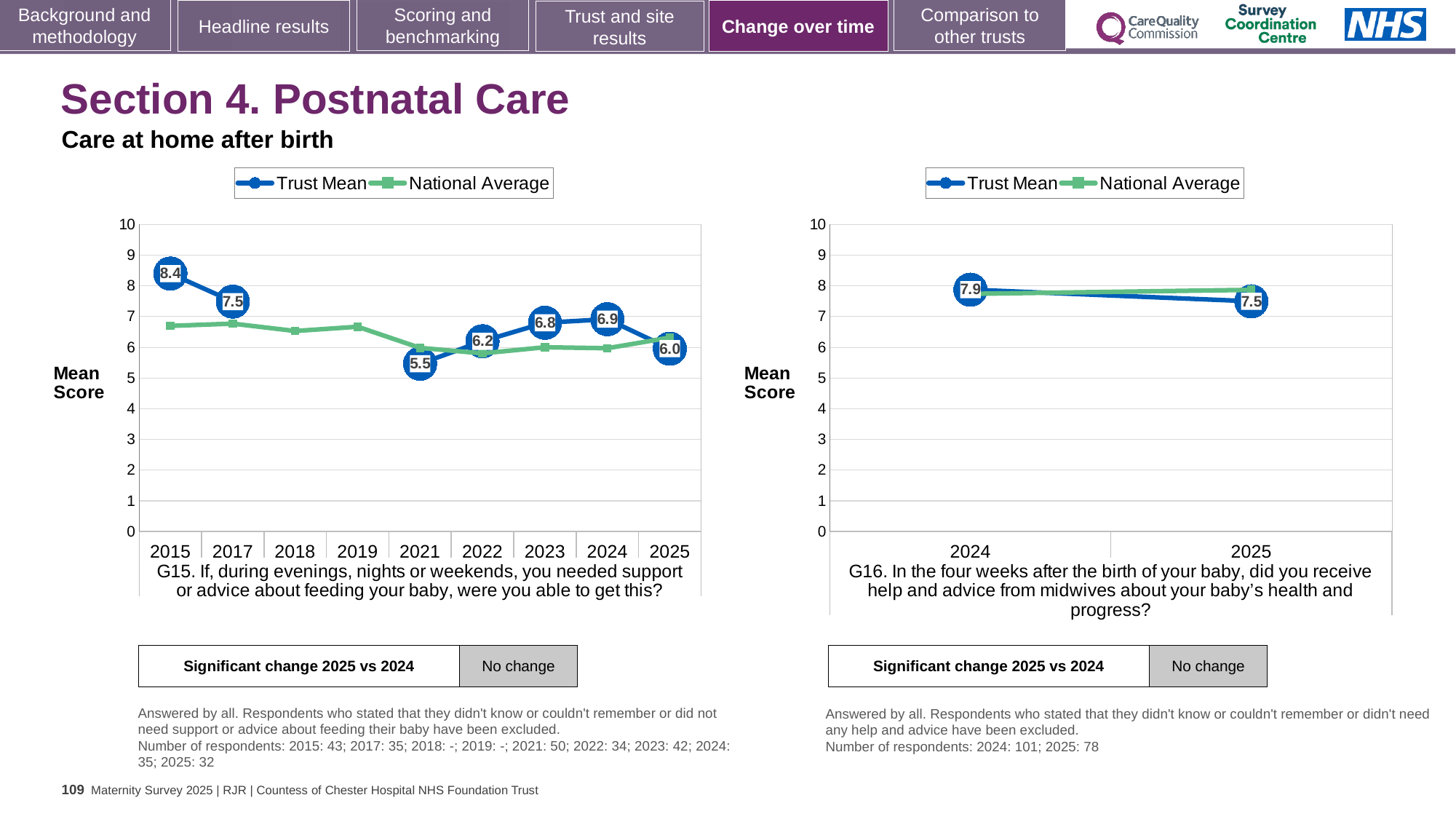
In the G15 chart on the left, which year has the lowest Trust Mean score? 2021 In the G15 chart on the left, which year has the highest Trust Mean score? 2015 In the G15 chart on the left, what is the Trust Mean score for 2025? 6.0 How many years are shown on the x axis of the G16 chart on the right? 2 In the G15 chart on the left, what is the Trust Mean score for 2015? 8.4 In the G15 chart on the left, is the Trust Mean score higher in 2023 or in 2022? 2023 In the G15 chart on the left, is the National Average for 2015 greater or less than 6? greater In the G15 chart on the left, what is the difference between the Trust Mean scores for 2024 and 2025? 0.9 In the G16 chart on the right, does the Trust Mean rise or fall from 2024 to 2025? Fall How many series does the legend of the G16 chart on the right list? 2 What kind of chart is the G16 chart on the right? Line chart In the G16 chart on the right, what is the Trust Mean score for 2024? 7.9